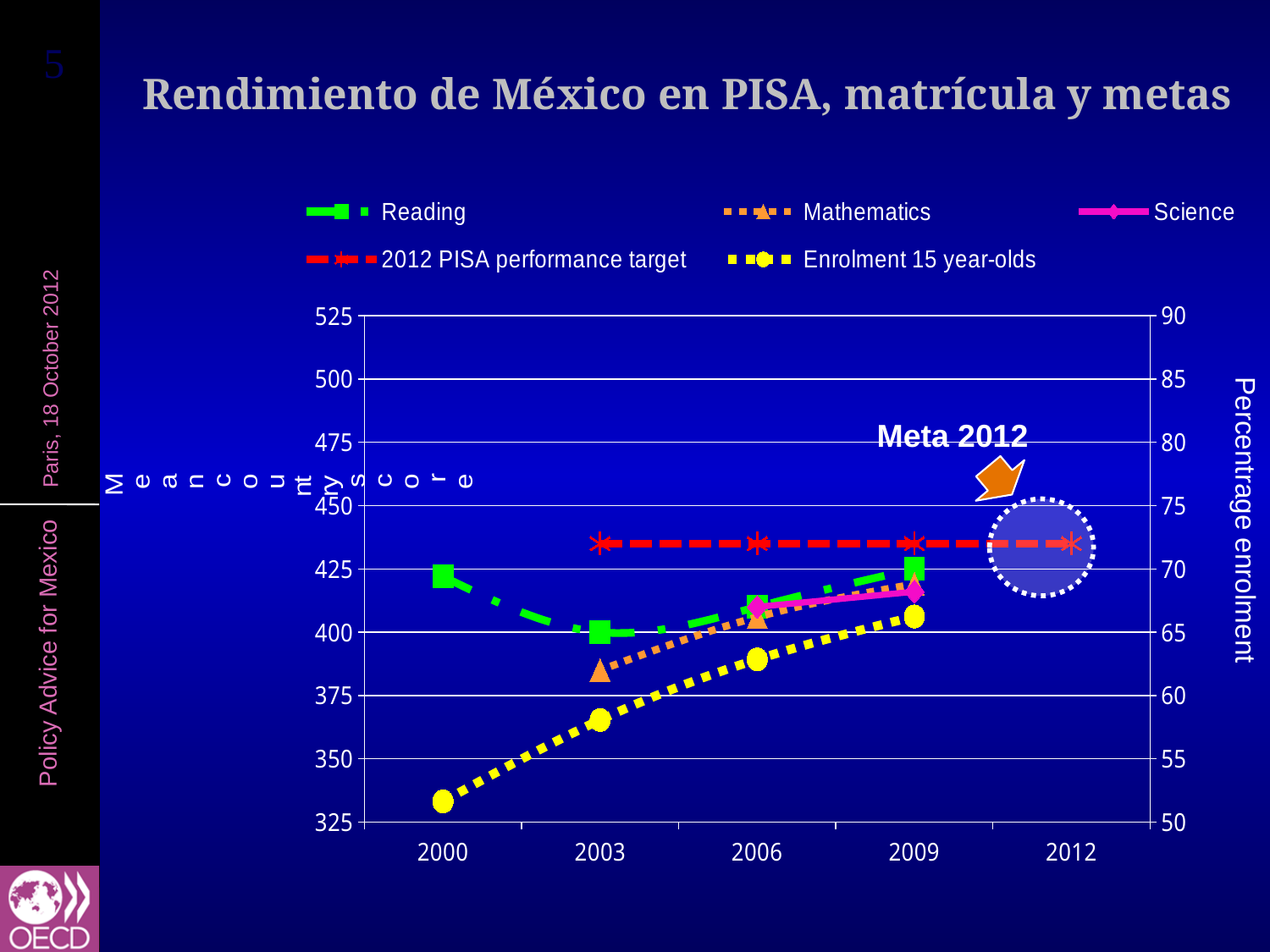
How many years are labelled on the x axis? 5 Is the Reading value for 2003 greater or less than 425? less What kind of chart is shown on the slide? line chart How many series does the legend list? 5 Does the Enrolment 15 year-olds series rise or fall from 2000 to 2009? rise Is the Reading value for 2000 greater or less than 400? greater Is the Mathematics value for 2003 greater or less than 400? less What is the label of the right-hand vertical axis? Percentage enrolment In 2003, which is higher: Reading or Mathematics? Reading